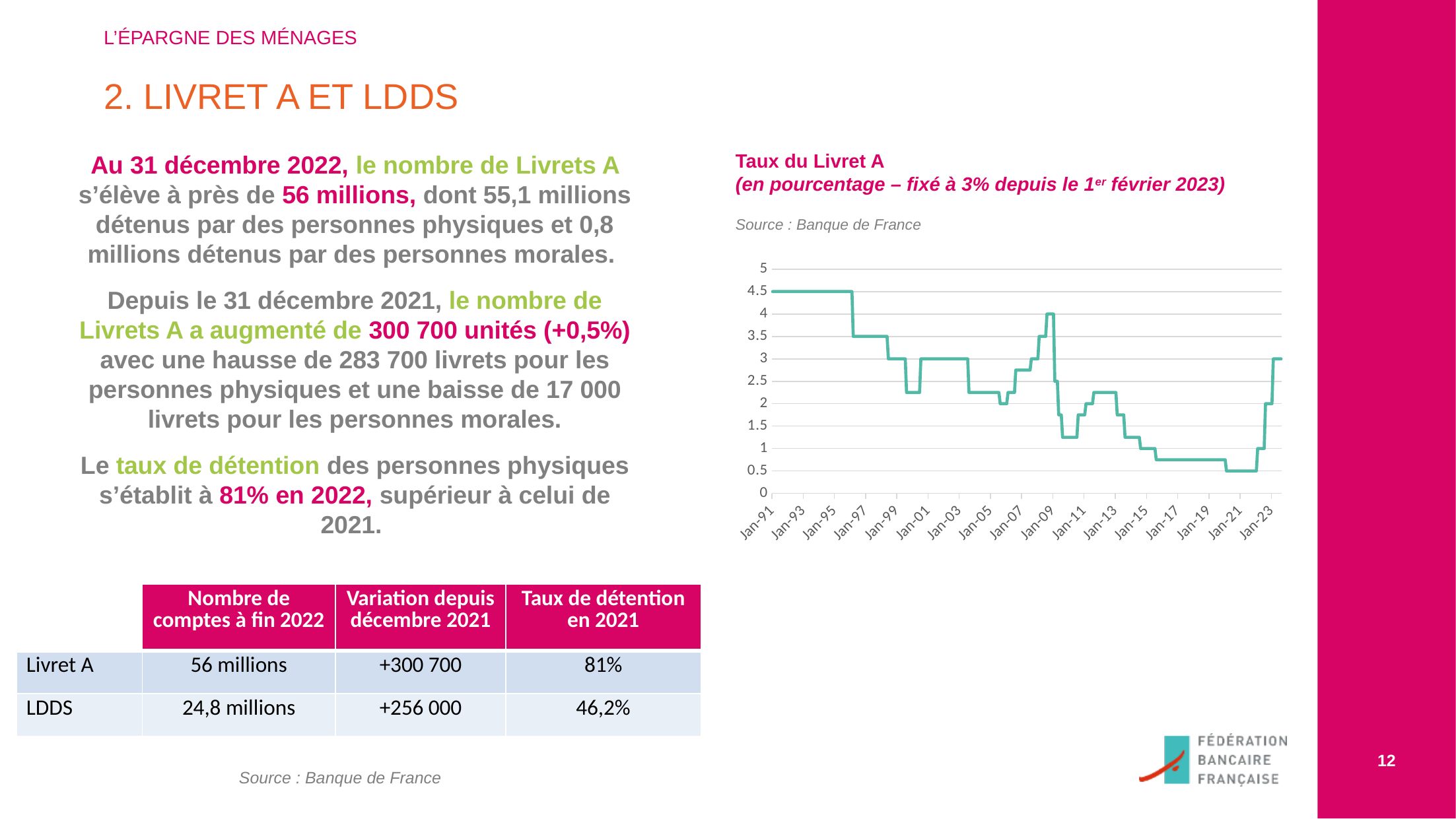
What is the lowest value reached by the Taux du Livret A on the chart? 0.5 Does the Taux du Livret A generally rise or fall from Jan-91 to Jan-21? fall How many lines (series) are plotted on the chart? 1 What is the value of the Taux du Livret A at Jan-23? 2 What kind of chart is shown on the slide? line chart Is the value of the Taux du Livret A at Jan-07 greater or less than 2? greater What is the highest value reached by the Taux du Livret A on the chart? 4.5 Is the value of the Taux du Livret A at Jan-03 greater or less than 2.5? greater What is the value of the Taux du Livret A at Jan-91? 4.5 Which is larger, the Taux du Livret A at Jan-93 or at Jan-13? Jan-93 Is the value of the Taux du Livret A at Jan-19 greater or less than 1? less What is the title of the chart? Taux du Livret A